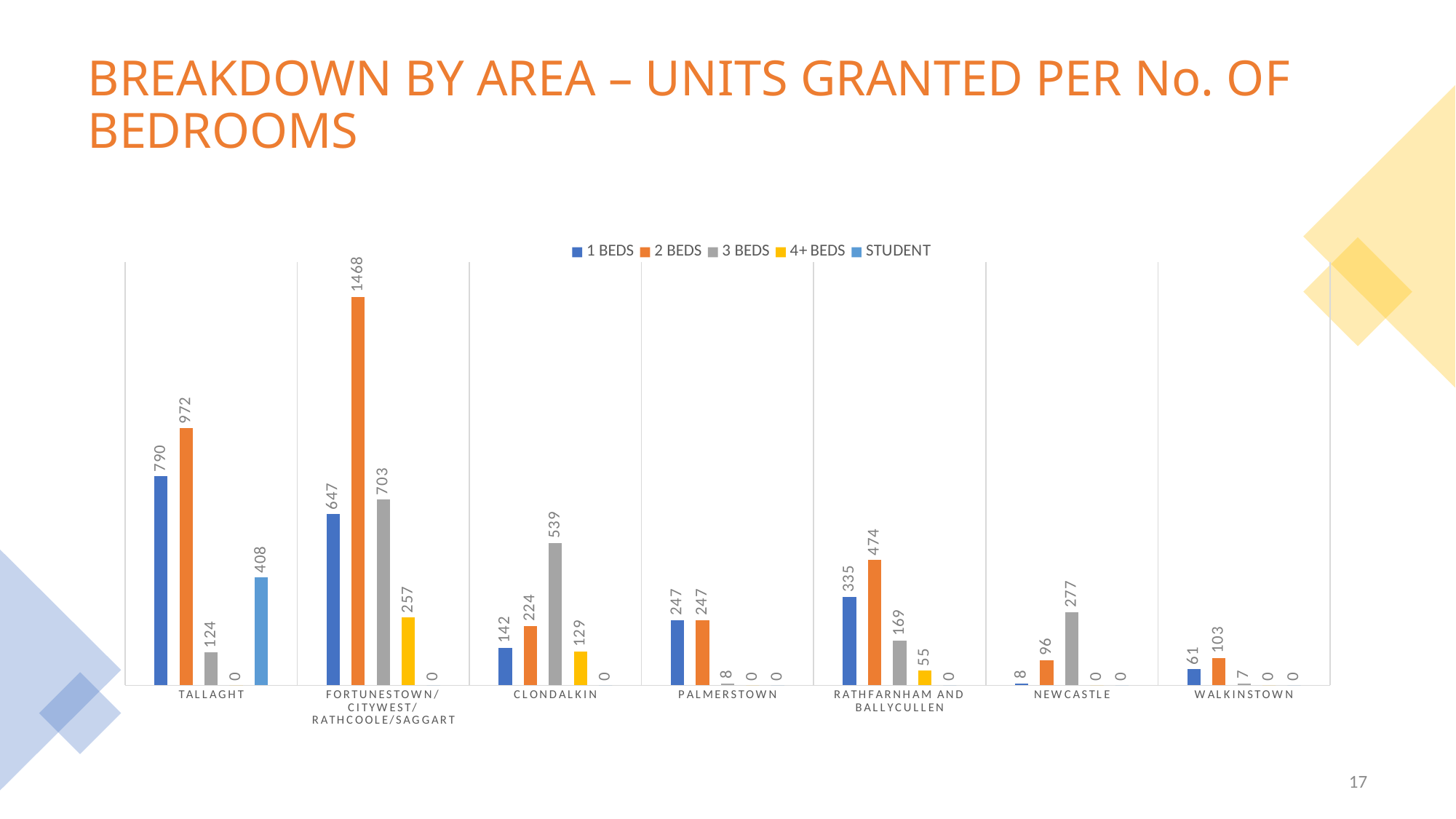
How many STUDENT units were granted in Tallaght? 408 Which series is shown in yellow in the legend? 4+ BEDS What is the value for 3 BEDS in Clondalkin? 539 Which is larger in Newcastle: the 3 BEDS value or the 2 BEDS value? 3 BEDS Which area has the highest value for 2 BEDS? Fortunestown/Citywest/Rathcoole/Saggart What is the difference between the 2 BEDS and 1 BEDS values for Fortunestown/Citywest/Rathcoole/Saggart? 821 How many areas are shown on the x axis? 7 How many units with 2 beds were granted in Tallaght? 972 What is the total number of units granted in Palmerstown across all series? 502 What kind of chart is shown on the slide? Bar chart Which area has the lowest value for 1 BEDS? Newcastle How many series does the legend list? 5